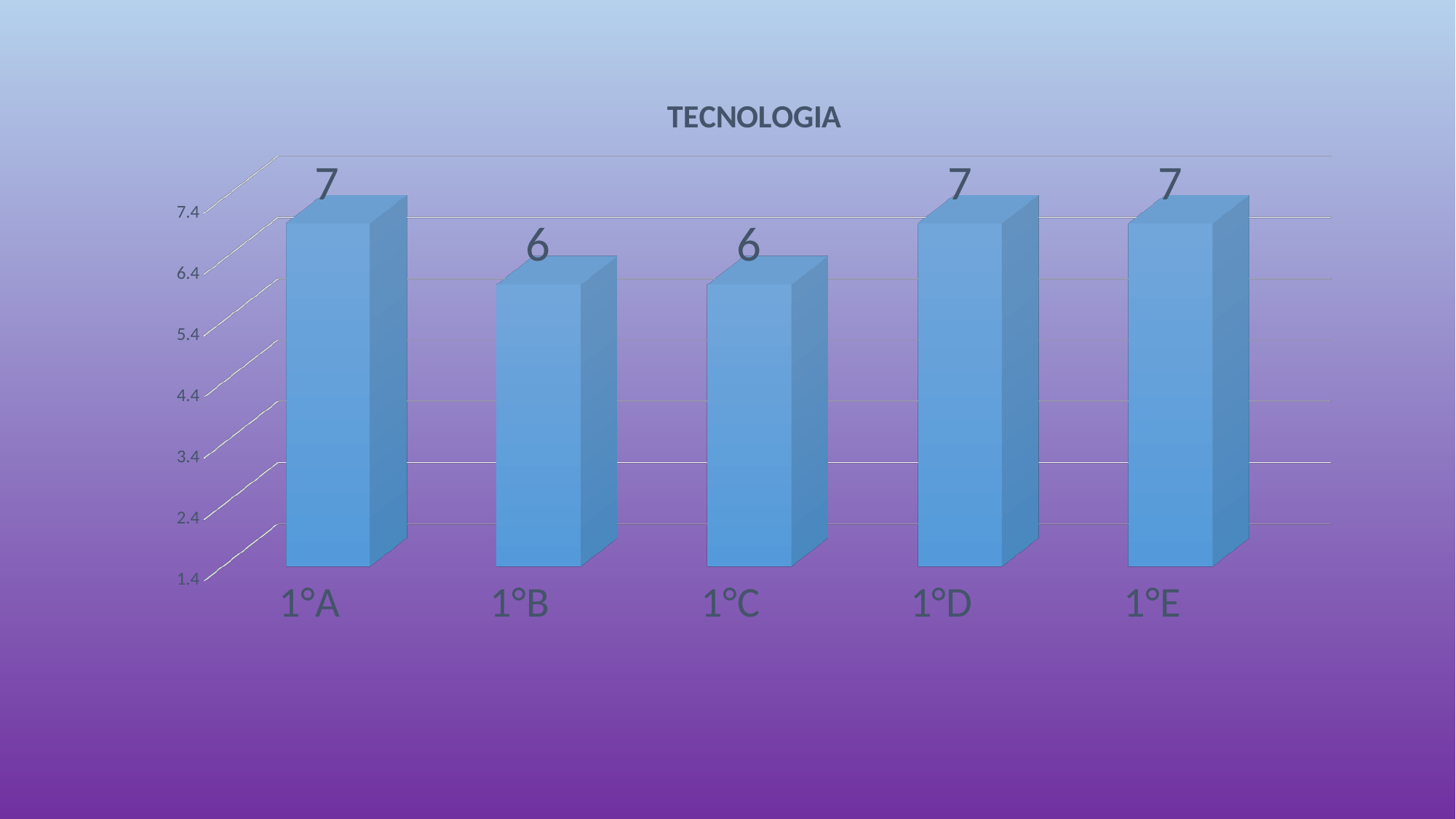
What kind of chart is shown on the slide? bar chart What is the value for 1°A? 7 What is the value for 1°E? 7 Is the value for 1°B greater or less than 4.4? greater What is the difference between the values for 1°A and 1°B? 1 How many categories are shown on the x axis? 5 What is the title of the chart? TECNOLOGIA What is the value for 1°C? 6 What is the value for 1°D? 7 What is the lowest value shown on the vertical axis? 1.4 What is the value for 1°B? 6 Which is larger, the value for 1°D or the value for 1°C? 1°D